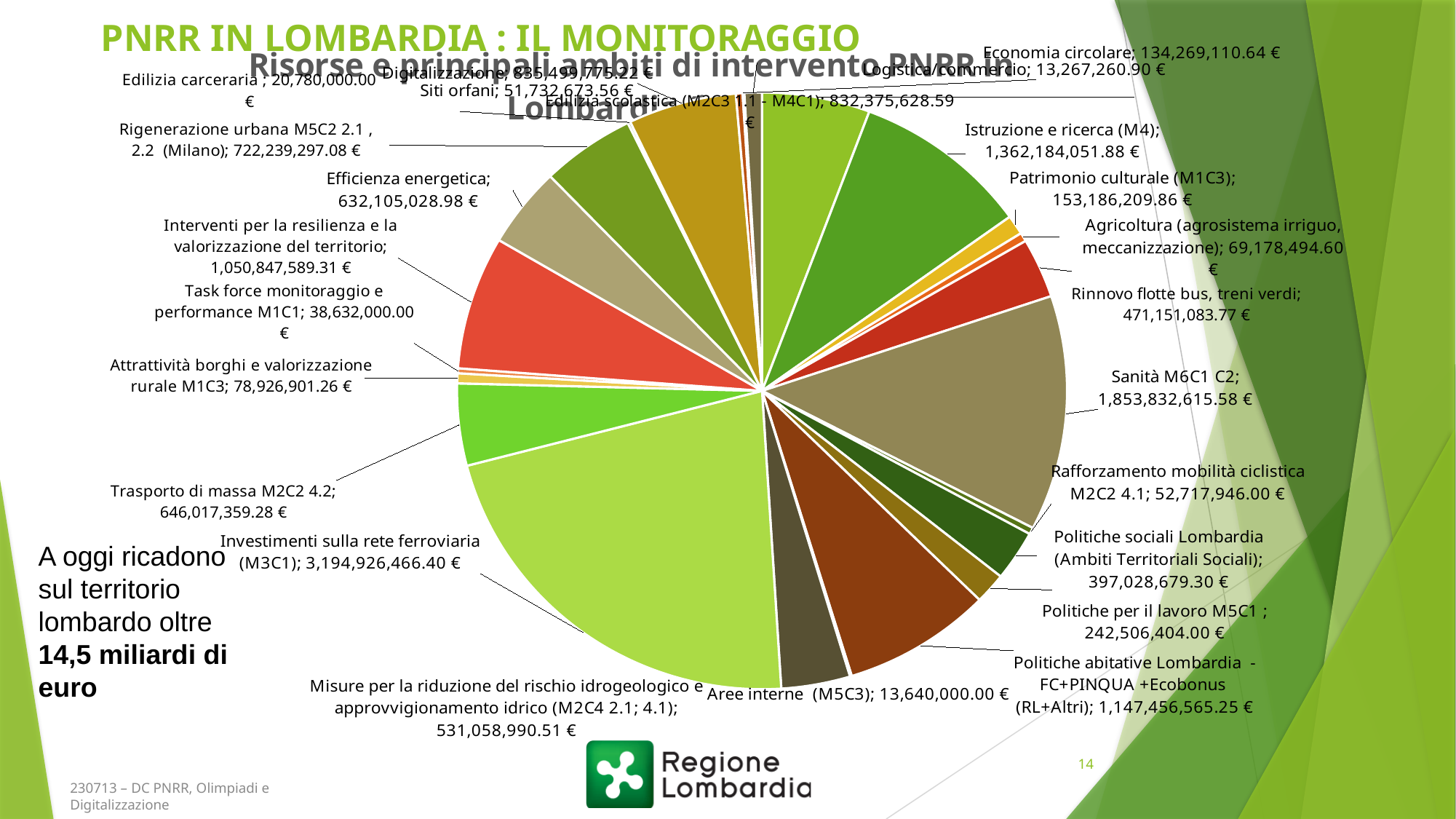
What is the value for Aree interne (M5C3)? 13,640,000.00 € What is the value for Efficienza energetica? 632,105,028.98 € What is the value for Rinnovo flotte bus, treni verdi? 471,151,083.77 € What is the difference between the values for Digitalizzazione and Edilizia scolastica (M2C3 1.1 - M4C1)? 3,124,146.63 € What kind of chart is shown on the slide? Pie chart What is the value for Istruzione e ricerca (M4)? 1,362,184,051.88 € What is the value for Sanità M6C1 C2? 1,853,832,615.58 € What is the value for Investimenti sulla rete ferroviaria (M3C1)? 3,194,926,466.40 € What is the difference between the values for Sanità M6C1 C2 and Istruzione e ricerca (M4)? 491,648,563.70 € Which category has the largest slice of the pie? Investimenti sulla rete ferroviaria (M3C1) Which is larger: Politiche sociali Lombardia (Ambiti Territoriali Sociali) or Politiche per il lavoro M5C1? Politiche sociali Lombardia (Ambiti Territoriali Sociali) According to the text on the slide, how much PNRR funding falls on the Lombardy territory today? Oltre 14,5 miliardi di euro